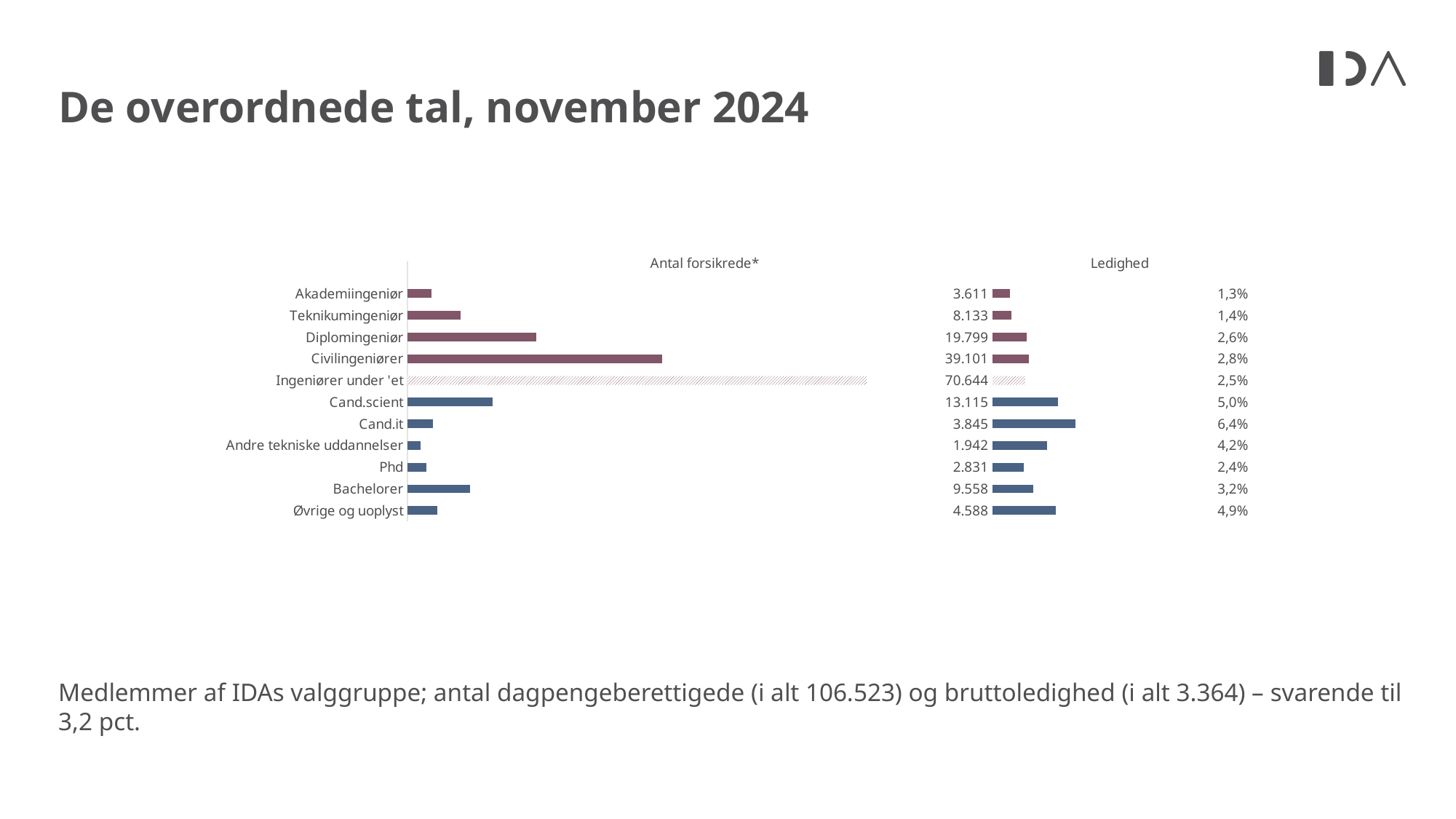
What kind of chart is the Ledighed chart? Bar chart In the Ledighed chart, which is larger, Cand.scient or Øvrige og uoplyst? Cand.scient In the Ledighed chart, which category has the lowest value? Akademiingeniør In the Antal forsikrede* chart, what is the difference between Diplomingeniør and Teknikumingeniør? 11.666 In the Ledighed chart, what is the value for Akademiingeniør? 1,3% In the Antal forsikrede* chart, what is the value for Bachelorer? 9.558 What is the title of the chart on the left? Antal forsikrede* In the Ledighed chart, which category has the highest value? Cand.it In the Antal forsikrede* chart, what is the value for Civilingeniører? 39.101 How many categories are shown in the Antal forsikrede* chart? 11 In the Antal forsikrede* chart, which category has the lowest value? Andre tekniske uddannelser In the Ledighed chart, what is the value for Cand.it? 6,4%